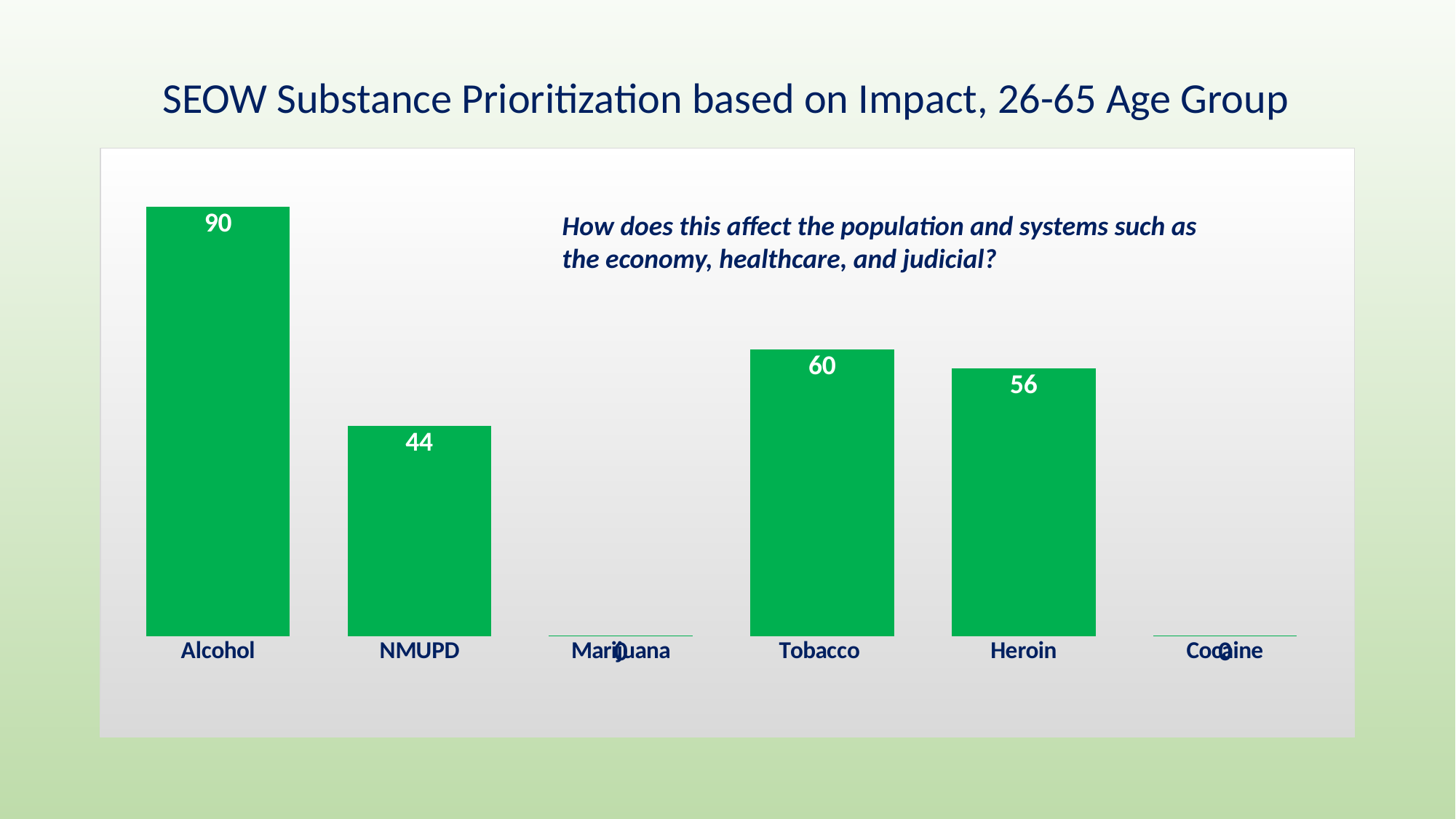
What kind of chart is shown on the slide? Bar chart What is the difference between the values for Alcohol and Tobacco? 30 What is the value for Tobacco? 60 What is the value for Alcohol? 90 What is the title of the slide? SEOW Substance Prioritization based on Impact, 26-65 Age Group How many substance categories are shown on the x axis? 6 Which has a larger value, NMUPD or Heroin? Heroin What is the difference between the values for Tobacco and Heroin? 4 What is the value for Marijuana? 0 What is the value for Heroin? 56 What is the value for NMUPD? 44 Which substance has the highest value? Alcohol